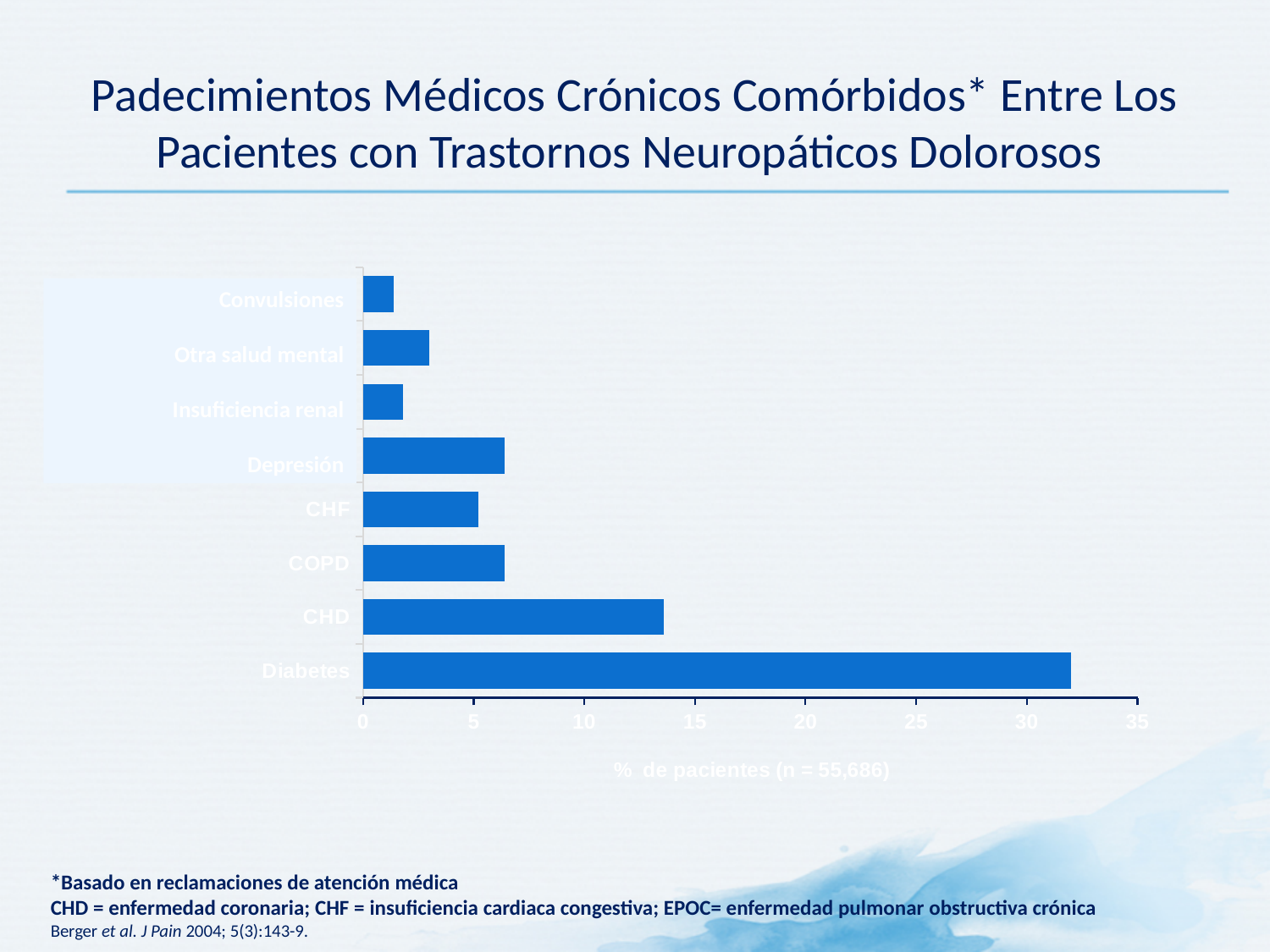
What is the label of the horizontal axis of the chart? % de pacientes (n = 55,686) Is the value for CHD greater or less than 15? less Which is larger, the value for CHD or the value for COPD? CHD Which condition has the highest percentage of patients? Diabetes Is the value for Diabetes greater or less than 30? greater Is the value for Otra salud mental greater or less than 5? less What kind of chart is shown on the slide? bar chart Which is larger, the value for Depresión or the value for Insuficiencia renal? Depresión How many comorbid conditions (categories) are plotted in the chart? 8